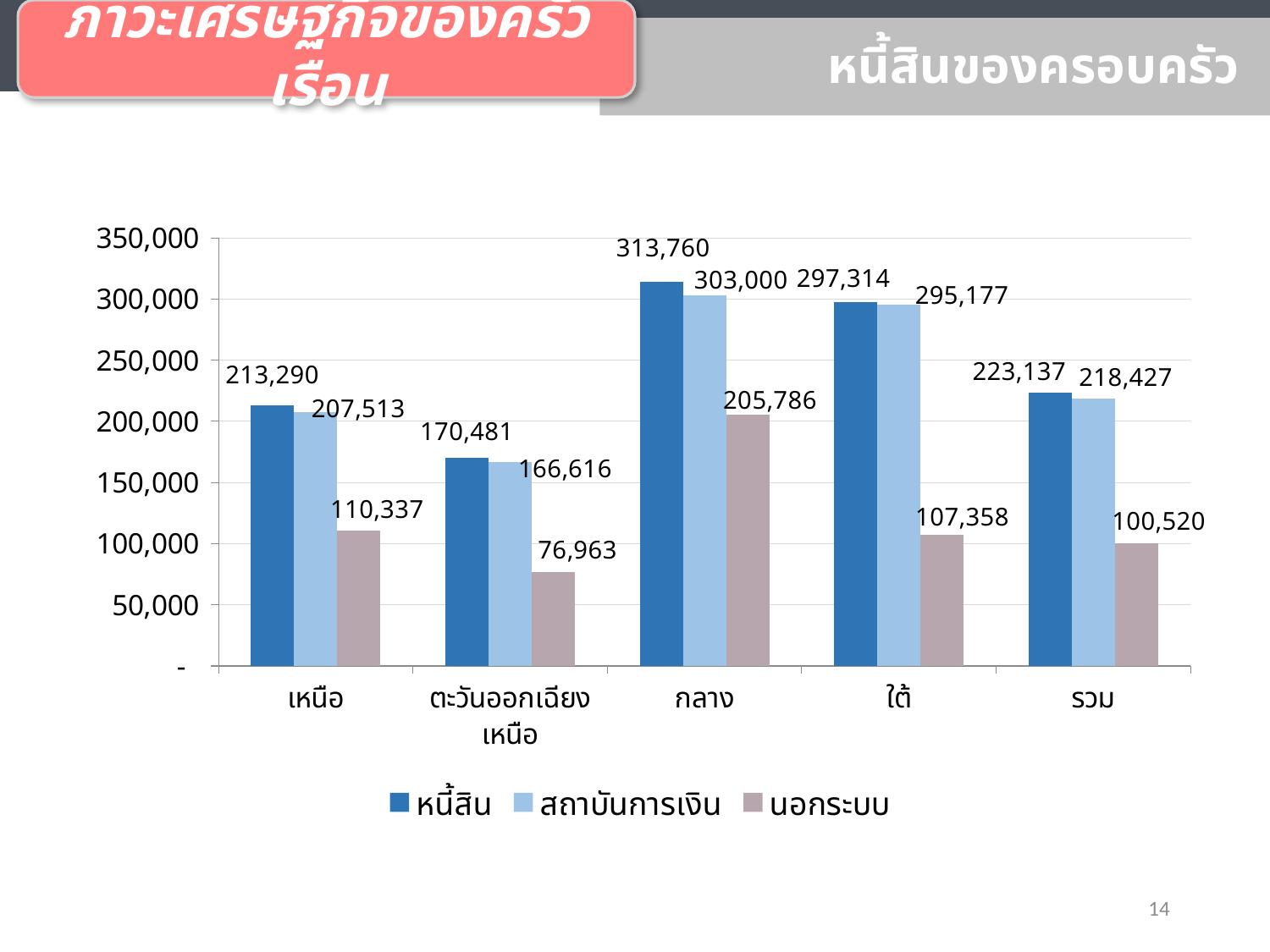
What is the value of สถาบันการเงิน for รวม? 218,427 What is the value of นอกระบบ for ตะวันออกเฉียงเหนือ? 76,963 What is the difference between the นอกระบบ values for เหนือ and ตะวันออกเฉียงเหนือ? 33,374 Which category has the lowest นอกระบบ value? ตะวันออกเฉียงเหนือ Is the นอกระบบ value for กลาง greater or less than 200,000? greater What is the difference between หนี้สิน and สถาบันการเงิน for กลาง? 10,760 Which is larger, the หนี้สิน value for เหนือ or for รวม? รวม What is the value of หนี้สิน for กลาง? 313,760 Which category has the highest หนี้สิน value? กลาง How many series does the legend list? 3 What kind of chart is shown on the slide? bar chart How many categories are shown on the x axis? 5